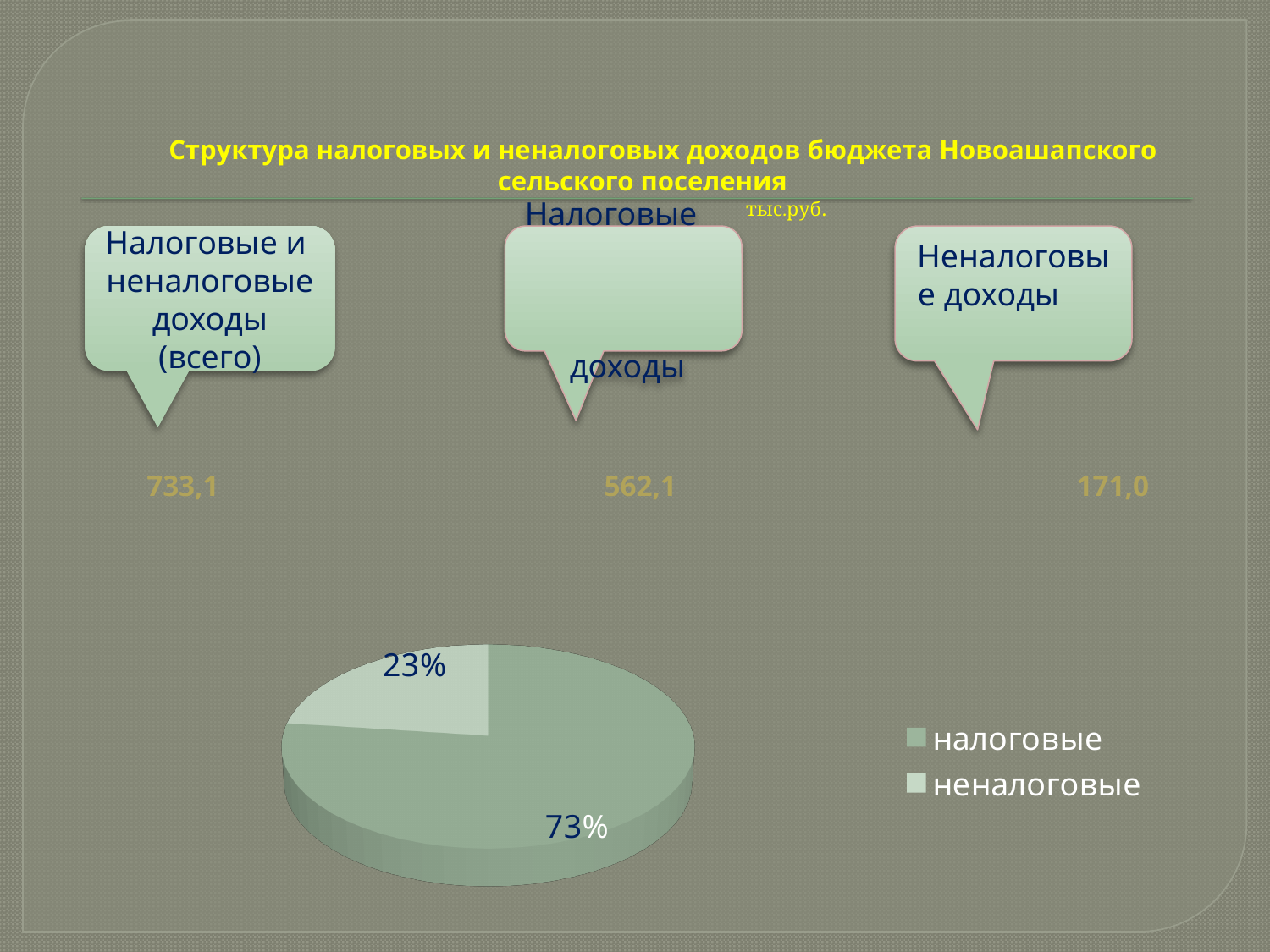
Which legend entry is listed first in the pie chart legend? налоговые How many entries does the pie chart legend list? 2 What share of the pie does the неналоговые slice represent? 23% Which slice of the pie chart is the largest? налоговые How many slices does the pie chart have? 2 Is the pie chart drawn in 3D or flat 2D? 3D What percentage does the pie chart show for налоговые? 73% By how many percentage points does the налоговые slice exceed the неналоговые slice? 50 What type of chart is shown on the slide? pie chart What percentage does the pie chart show for неналоговые? 23% Which is larger in the pie chart, налоговые or неналоговые? налоговые Which slice of the pie chart is the smallest? неналоговые